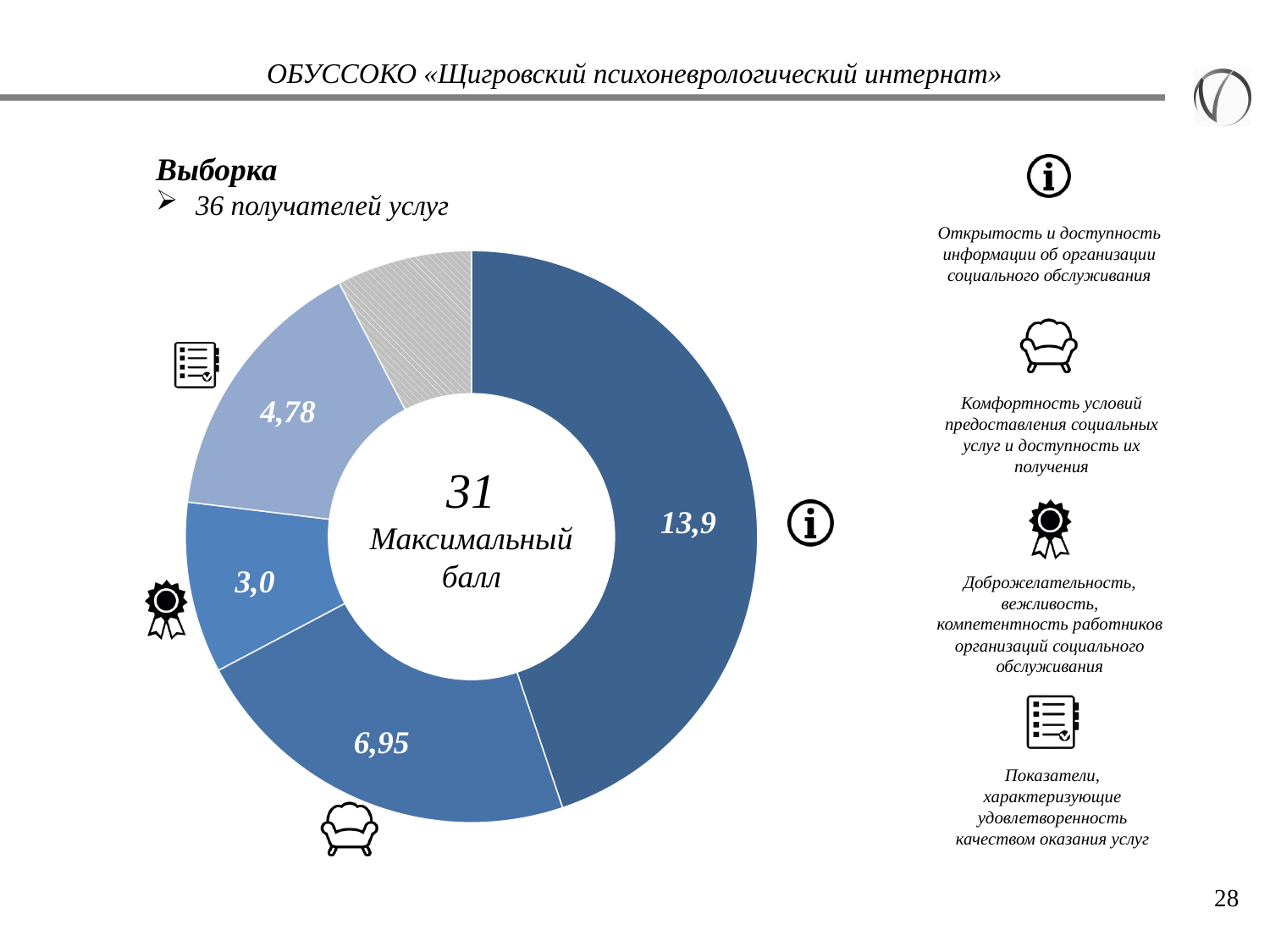
What value is shown for the slice marked with the armchair icon (Комфортность условий предоставления социальных услуг)? 6,95 How many service recipients are in the sample (Выборка) stated on the slide? 36 What value is shown for the slice marked with the checklist icon (Показатели, характеризующие удовлетворенность качеством оказания услуг)? 4,78 Which labeled slice has the highest value? 13,9 (Открытость и доступность информации) What maximum score is written in the centre of the chart? 31 Which labeled slice has the lowest value? 3,0 (Доброжелательность, вежливость, компетентность работников) Which is larger: the value for the checklist icon slice or the medal icon slice? The checklist icon slice (4,78) What value is shown for the slice marked with the information icon (Открытость и доступность информации)? 13,9 What value is shown for the slice marked with the medal icon (Доброжелательность, вежливость, компетентность работников)? 3,0 How many slices of the chart have a printed data label? 4 What type of chart is shown on the slide? Donut (pie) chart What is the difference between the value for the information icon slice (13,9) and the armchair icon slice (6,95)? 6,95